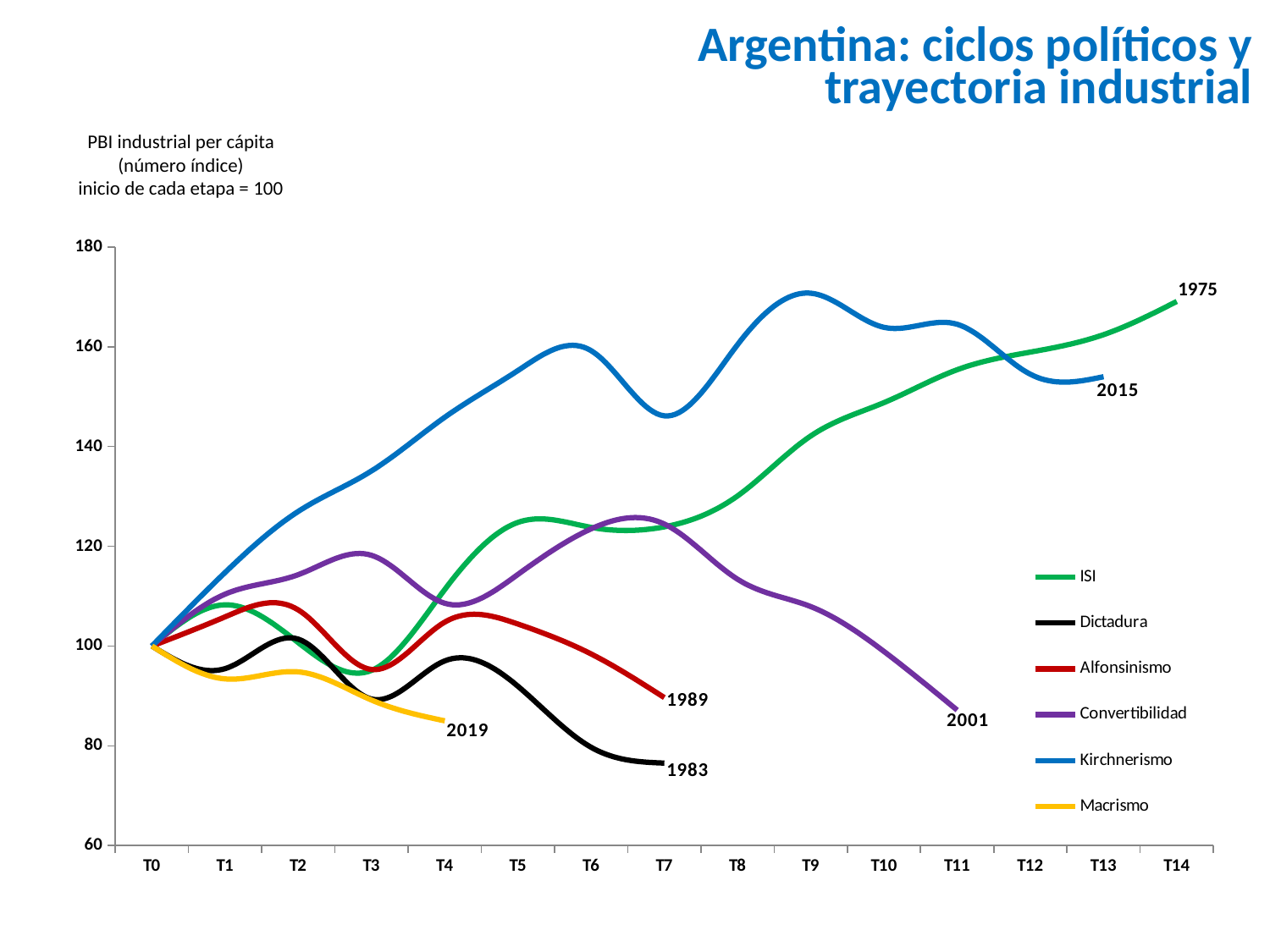
How many series does the legend list? 6 At T9, which series has the higher value, Kirchnerismo or ISI? Kirchnerismo Is the value for Kirchnerismo at T9 greater or less than 160? greater Which year label appears at the end of the Kirchnerismo line? 2015 How many points are labelled on the x axis (T0 to T14)? 15 What kind of chart is shown on the slide? line chart Is the value for Macrismo at T4 greater or less than 100? less Is the value for Convertibilidad at T11 greater or less than 100? less Does the Convertibilidad line rise or fall from T7 to T11? fall Which series reaches the highest value on the chart? Kirchnerismo What is the value of every series at T0? 100